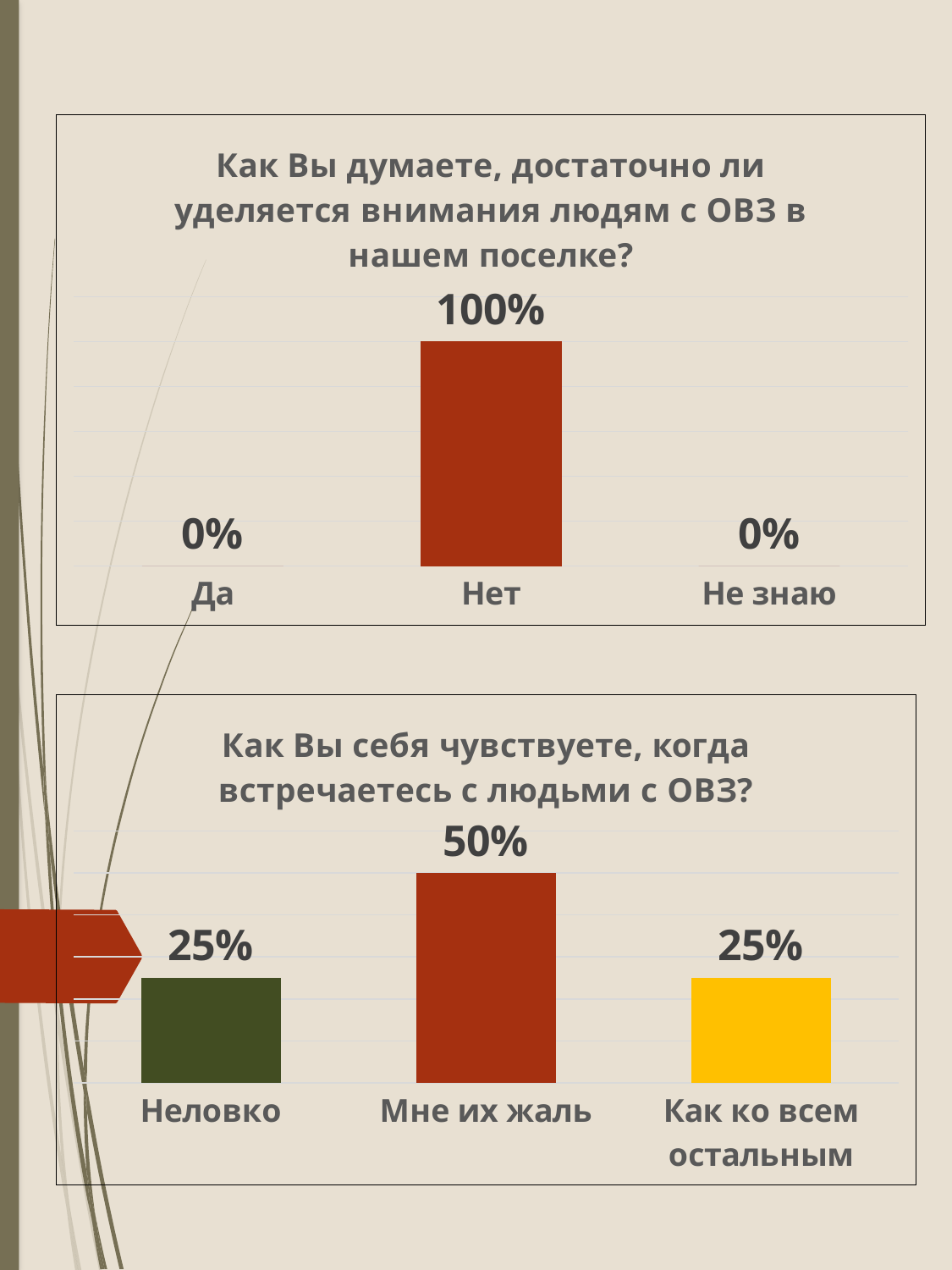
What kind of chart is the top chart? Bar chart In the top chart, what is the value for "Нет"? 100% How many categories are shown in the bottom chart? 3 In the top chart, what is the value for "Да"? 0% In the top chart, which category has the highest value? Нет In the bottom chart, which category has the highest value? Мне их жаль How many categories are shown in the top chart? 3 In the bottom chart, which is larger: "Мне их жаль" or "Как ко всем остальным"? Мне их жаль In the bottom chart, what is the value for "Мне их жаль"? 50% In the bottom chart, what is the value for "Как ко всем остальным"? 25% In the bottom chart, what is the difference between "Мне их жаль" and "Неловко"? 25% In the bottom chart, what is the value for "Неловко"? 25%